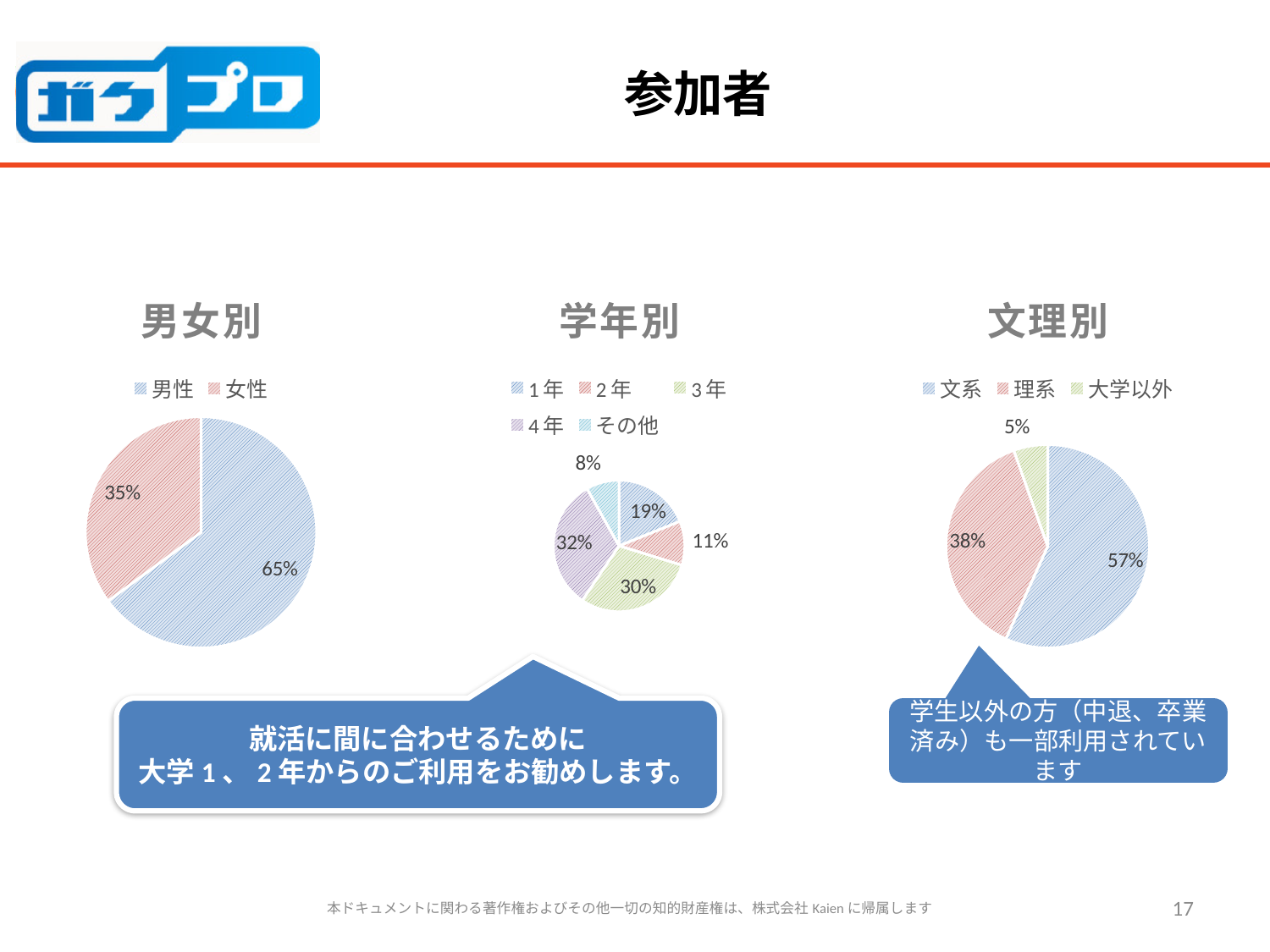
In the 学年別 chart, what percentage is 1年? 19% What kind of chart is the 男女別 chart? Pie chart How many categories does the legend of the 学年別 chart list? 5 In the 学年別 chart, what percentage is 3年? 30% In the 文理別 chart, what percentage is 理系? 38% In the 男女別 chart, what percentage is 男性? 65% In the 文理別 chart, which is larger, 文系 or 理系? 文系 In the 学年別 chart, which category has the largest share? 4年 In the 男女別 chart, what percentage is 女性? 35% In the 学年別 chart, which category has the smallest share? その他 In the 文理別 chart, what percentage is 大学以外? 5% In the 男女別 chart, what is the difference between the 男性 and 女性 shares? 30%